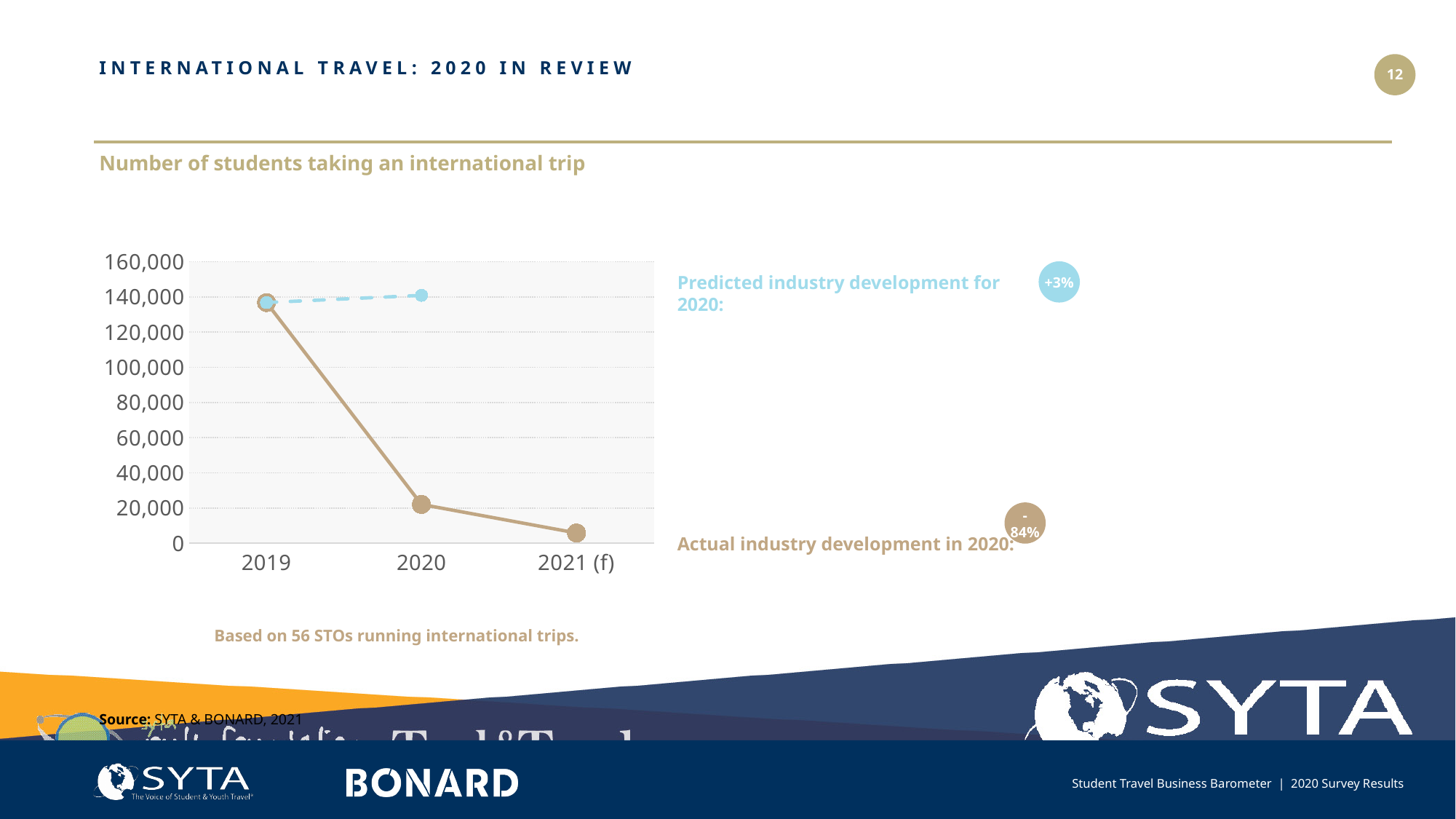
Is the 2020 value on the dashed predicted line greater or less than 120,000? greater What is the title of the chart? Number of students taking an international trip Do the values on the solid line rise or fall from 2019 to 2021 (f)? fall Which year has the highest number of students on the solid line? 2019 Which year has the lowest number of students on the solid line? 2021 (f) Is the value for 2021 (f) greater or less than 20,000? less How many years are shown on the x axis of the chart? 3 Is the value for 2020 on the solid line greater or less than 40,000? less What type of chart is shown on the slide? line chart For 2020, which is larger: the dashed predicted value or the solid actual value? the dashed predicted value Which is larger, the 2019 value or the 2020 value on the solid line? 2019